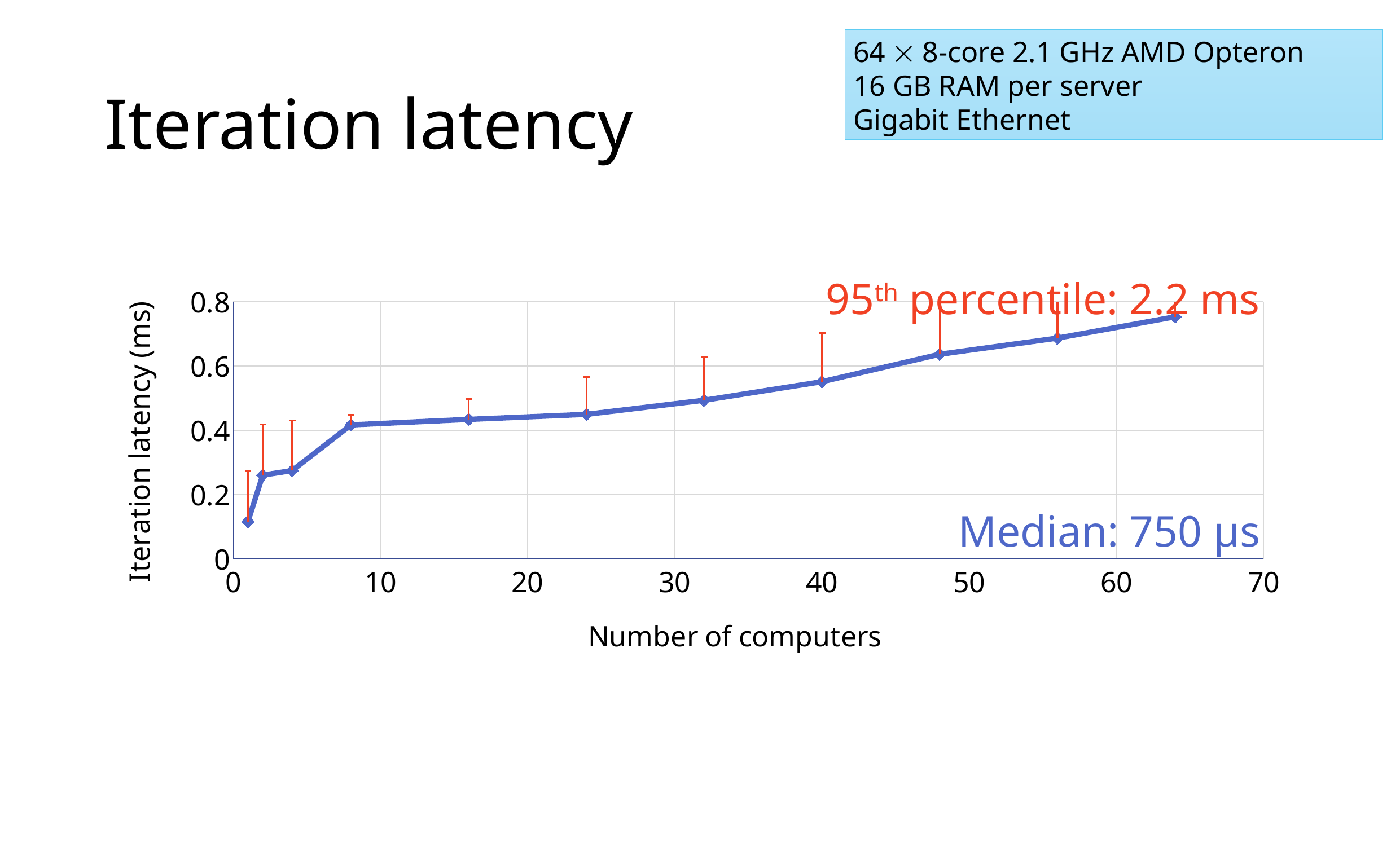
What is the title of the slide's chart? Iteration latency Which has the larger iteration latency: 16 computers or 56 computers? 56 computers Is the iteration latency for 1 computer greater or less than 0.2 ms? less What kind of chart is shown on the slide? line chart At which number of computers is the iteration latency lowest? 1 At which number of computers is the iteration latency highest? 64 Does iteration latency rise or fall as the number of computers increases? rises Is the iteration latency for 40 computers greater or less than 0.4 ms? greater Is the iteration latency for 64 computers greater or less than 0.6 ms? greater How many data points are plotted on the line? 11 What is the label of the x axis? Number of computers